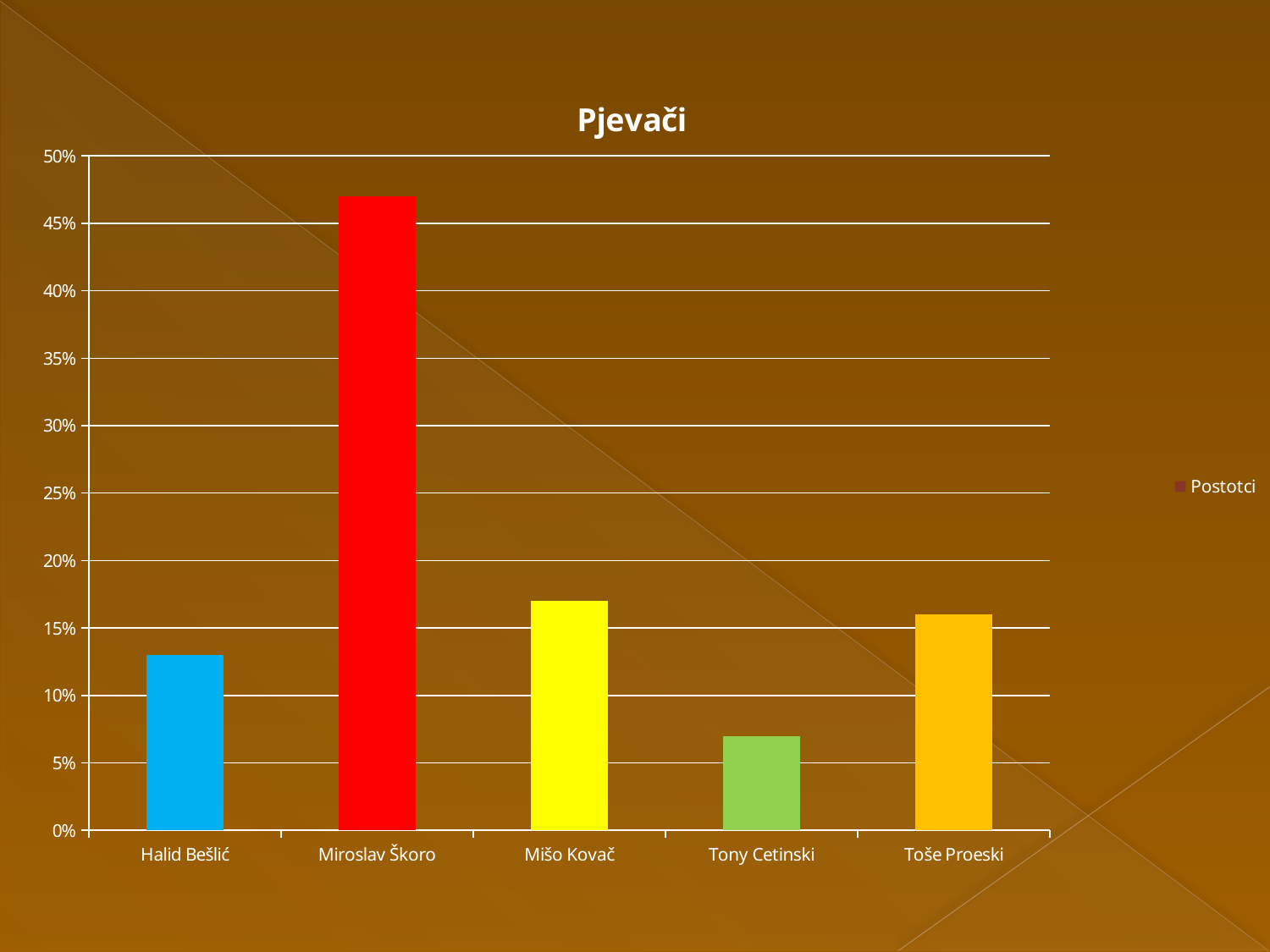
Is the value for Halid Bešlić greater or less than 15%? less What is the name of the series in the legend? Postotci Is the value for Tony Cetinski greater or less than 10%? less What is the title of the chart? Pjevači Which is larger, the value for Halid Bešlić or the value for Tony Cetinski? Halid Bešlić How many series does the legend list? 1 What kind of chart is shown on the slide? bar chart Which singer has the highest value? Miroslav Škoro Is the value for Miroslav Škoro greater or less than 45%? greater Which singer has the lowest value? Tony Cetinski How many singers (categories) are shown on the x axis? 5